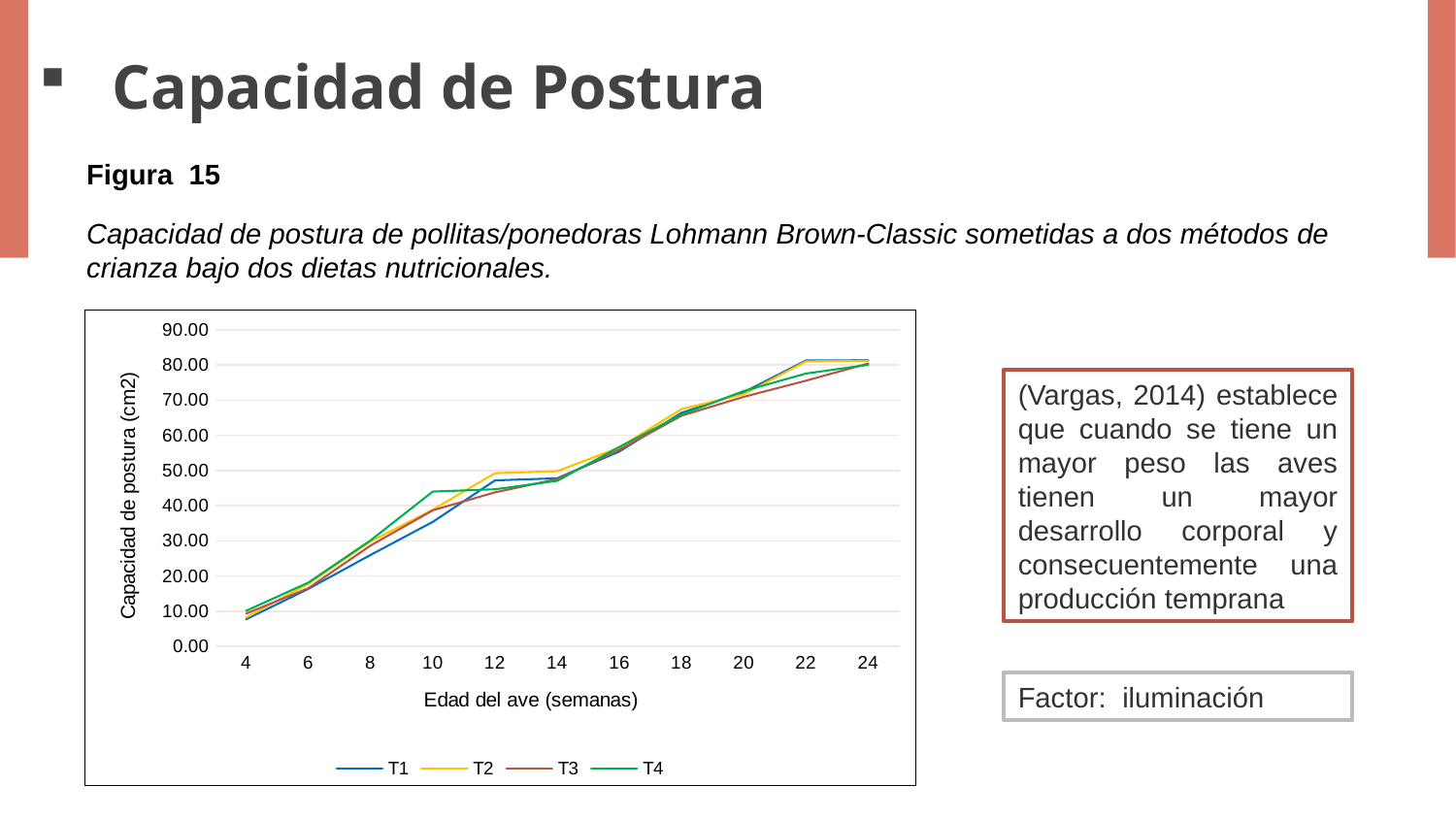
At week 22, which is larger, the value for T1 or the value for T3? T1 Do the values for T1 rise or fall as the age of the bird increases from week 4 to week 24? rise How many series does the legend list? 4 Is the value for T4 at week 10 greater or less than 40? greater What is the label of the x axis? Edad del ave (semanas) How many age points (weeks) are plotted along the x axis? 11 Which series has the highest value at week 10? T4 What kind of chart is shown on the slide? line chart Is the value for T2 at week 4 greater or less than 20? less Is the value for T3 at week 24 greater or less than 70? greater What is the label of the y axis? Capacidad de postura (cm2)